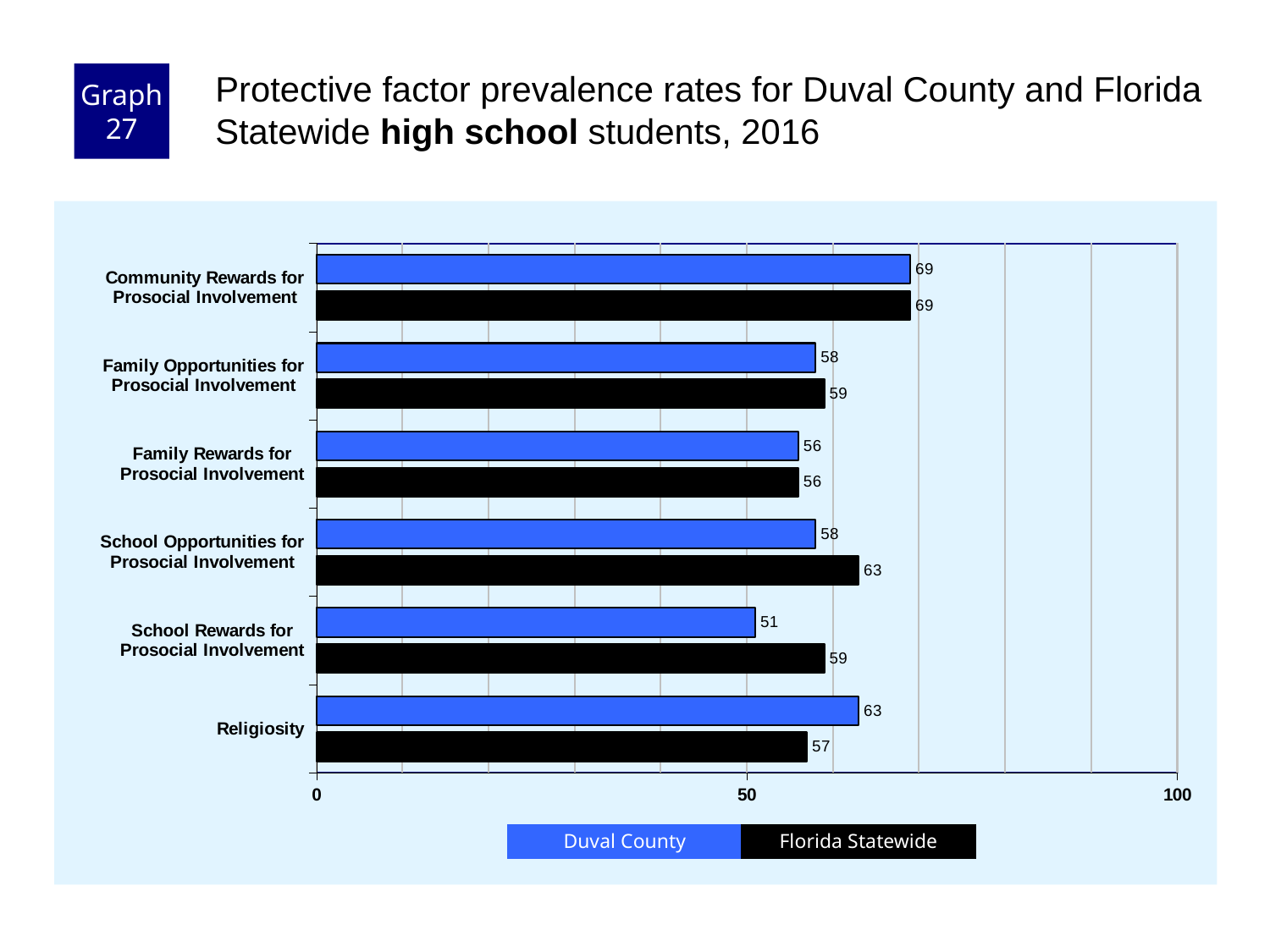
For Religiosity, which is larger: the Duval County value or the Florida Statewide value? Duval County What is the Duval County value for Religiosity? 63 What is the Duval County value for School Rewards for Prosocial Involvement? 51 How many series does the legend list? 2 What kind of chart is shown on the slide? Bar chart What is the difference between the Florida Statewide and Duval County values for School Rewards for Prosocial Involvement? 8 Which category has the lowest Duval County value? School Rewards for Prosocial Involvement What is the Florida Statewide value for School Opportunities for Prosocial Involvement? 63 For School Opportunities for Prosocial Involvement, which is larger: the Duval County value or the Florida Statewide value? Florida Statewide Which category has the highest Duval County value? Community Rewards for Prosocial Involvement Which category has the lowest Florida Statewide value? Family Rewards for Prosocial Involvement How many categories are shown on the chart? 6